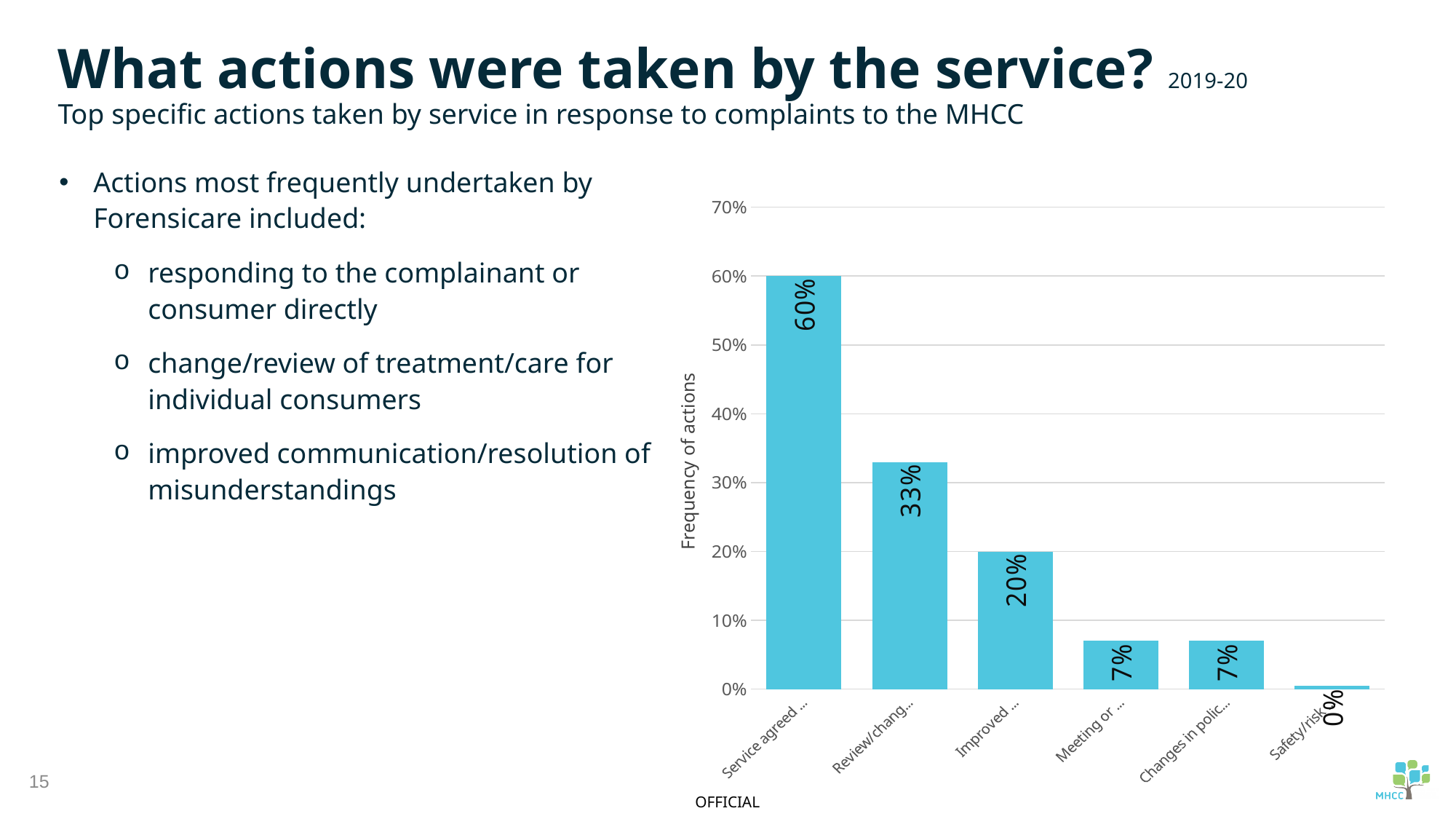
What is the label of the vertical axis of the chart? Frequency of actions What is the value of the bar labelled "Safety/risk..."? 0% Which category has the highest value in the chart? Service agreed ... (the first bar) Which is larger, the value for "Improved ..." or the value for "Meeting or ..."? Improved ... What kind of chart is shown on the slide? bar chart Which category has the lowest value in the chart? Safety/risk... (the last bar) Do the bar values rise or fall from left to right across the chart? fall What is the value of the first (leftmost) bar, labelled "Service agreed ..."? 60% What is the value of the bar labelled "Review/chang..."? 33% How many bars (categories) does the chart show? 6 What is the value of the bar labelled "Improved ..."? 20% What is the difference between the first bar (60%) and the second bar (33%)? 27%